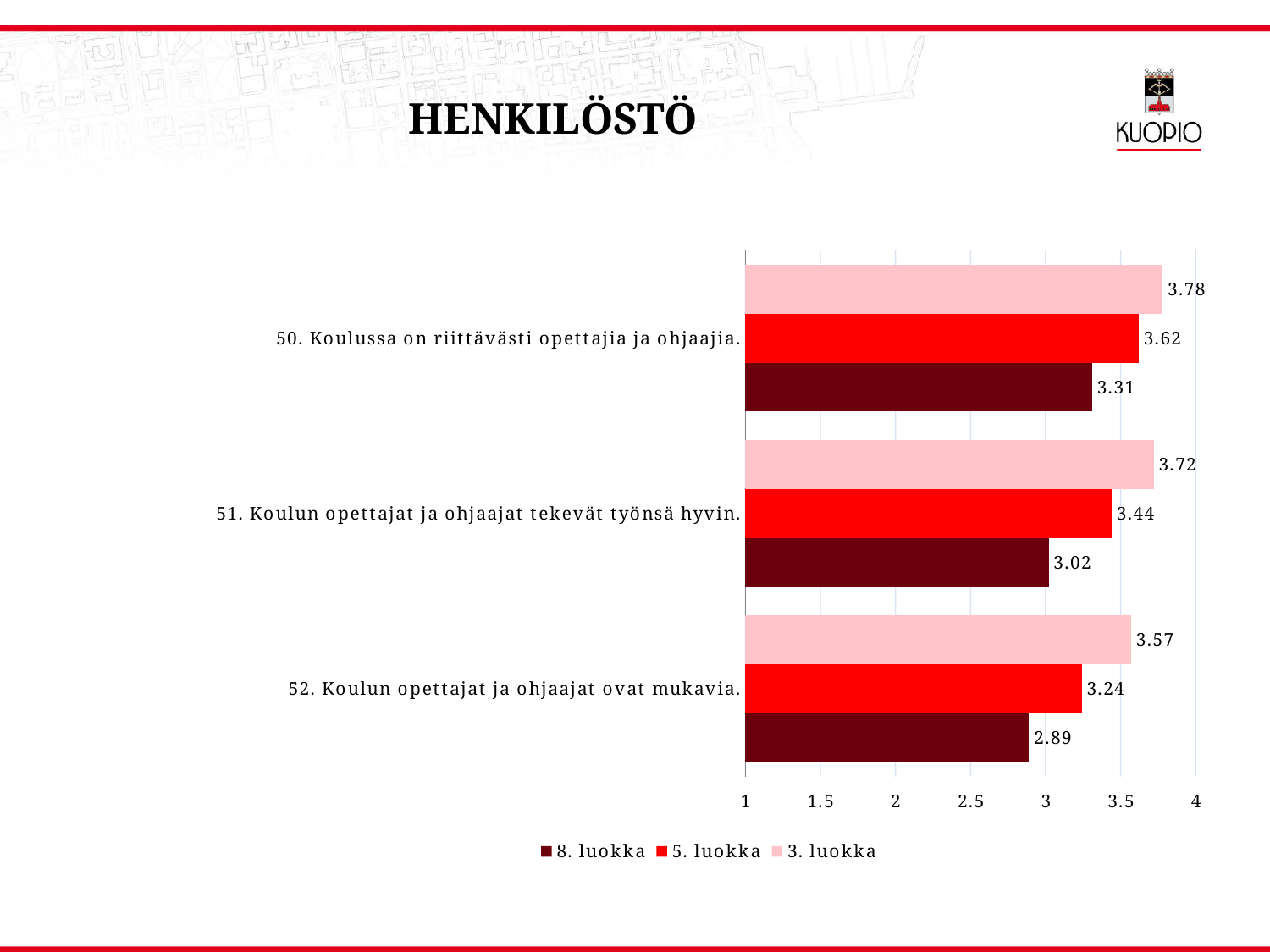
On item 51, which is larger: the value for 5. luokka or the value for 8. luokka? 5. luokka Which item has the highest value for 8. luokka? 50. Koulussa on riittävästi opettajia ja ohjaajia. What is the difference between the 3. luokka and 8. luokka values on item 52? 0.68 What is the value for 5. luokka on item 51 (Koulun opettajat ja ohjaajat tekevät työnsä hyvin)? 3.44 Is the value for 8. luokka on item 52 greater or less than 3? less Which item has the lowest value for 3. luokka? 52. Koulun opettajat ja ohjaajat ovat mukavia. What is the value for 3. luokka on item 50 (Koulussa on riittävästi opettajia ja ohjaajia)? 3.78 How many items (categories) are shown on the chart? 3 What kind of chart is shown on the slide? bar chart How many series does the legend list? 3 What is the value for 8. luokka on item 52 (Koulun opettajat ja ohjaajat ovat mukavia)? 2.89 What is the title of the slide containing the chart? HENKILÖSTÖ